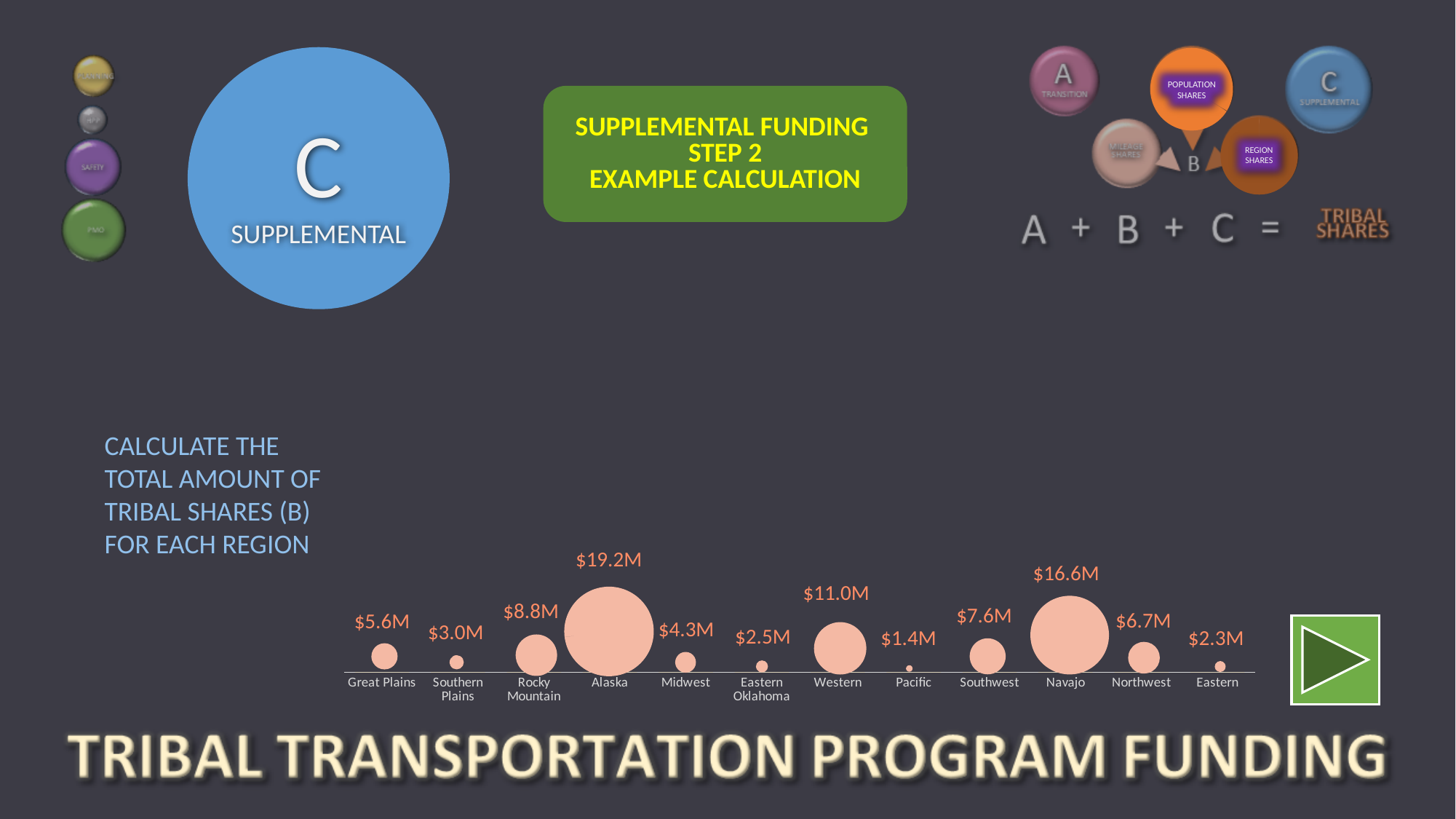
How many regions are shown in the chart? 12 What is the tribal shares value shown for Alaska? $19.2M What is the value shown for the Southwest region? $7.6M What is the difference between the values for Western and Rocky Mountain? $2.2M Which region has the lowest tribal shares value? Pacific What is the value shown for the Navajo region? $16.6M What is the value shown for Eastern Oklahoma? $2.5M What is the difference between the values for Alaska and Navajo? $2.6M Which has a larger value, Northwest or Great Plains? Northwest What kind of chart is used to show the tribal shares by region? Bubble chart Which region has the highest tribal shares value? Alaska What colour are the bubbles in the chart? Light orange (salmon)